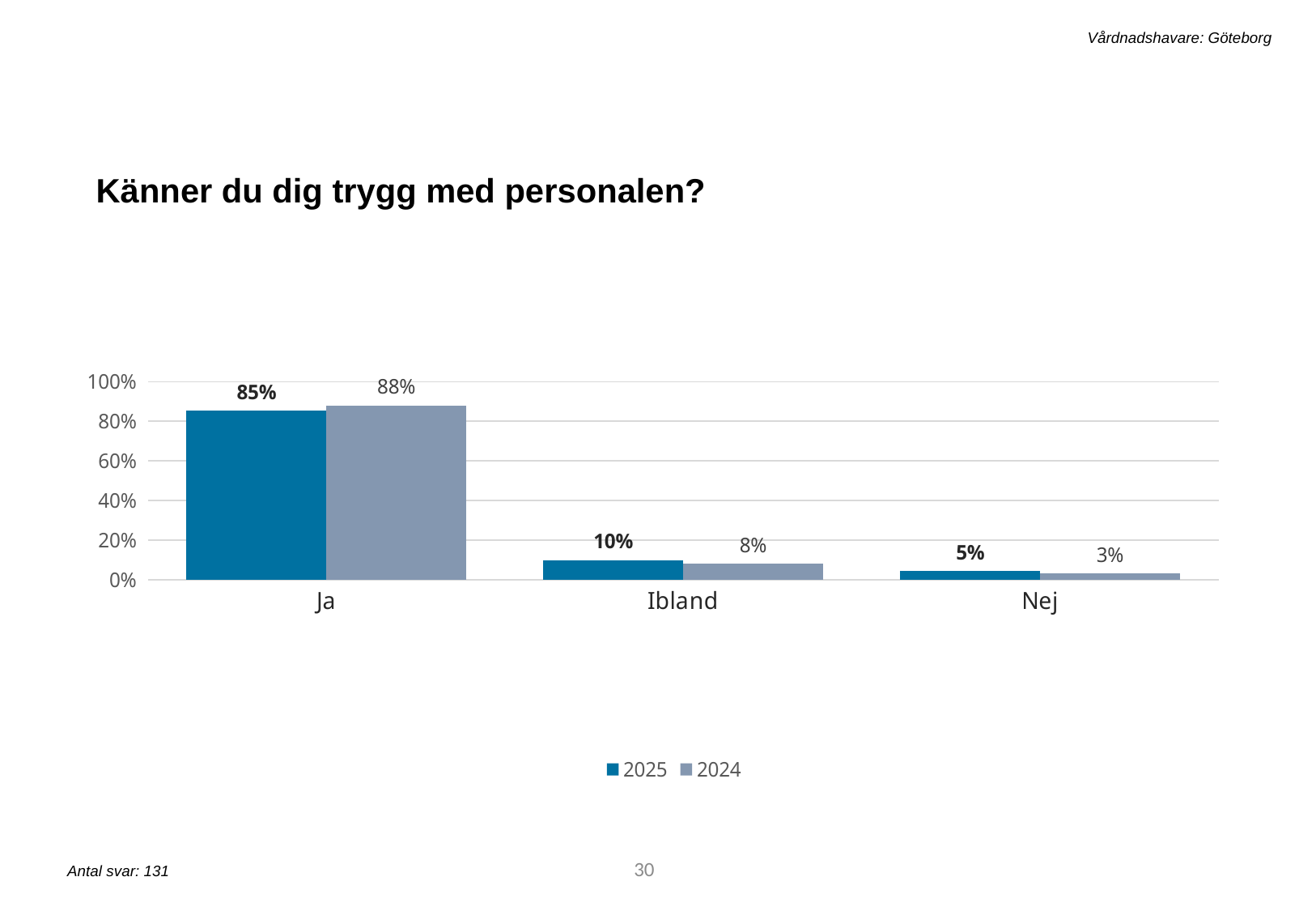
How many series does the legend list? 2 What is the value for Nej in the 2024 series? 3% Which category has the lowest value in the 2024 series? Nej Which is larger for Ibland: the 2025 value or the 2024 value? 2025 What is the difference between the 2024 and 2025 values for Ja? 3% What is the value for Ibland in the 2025 series? 10% What is the value for Ja in the 2025 series? 85% Which category has the highest value in the 2025 series? Ja What kind of chart is shown on the slide? bar chart How many categories are shown on the x axis? 3 Is the 2025 value for Ja greater or less than 80%? greater What is the value for Ja in the 2024 series? 88%